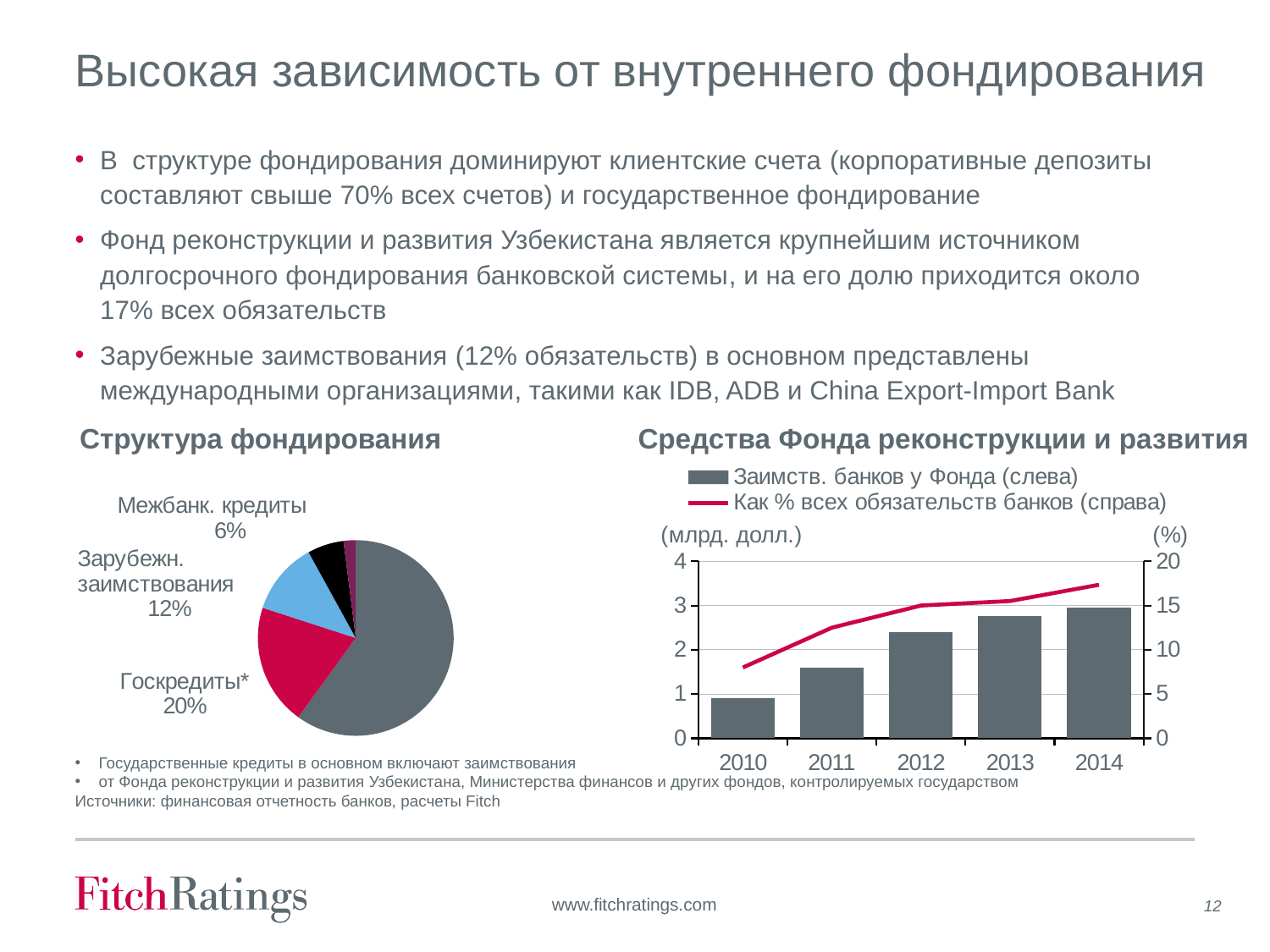
In the pie chart 'Структура фондирования', what share is shown for Госкредиты*? 20% What type of chart is 'Структура фондирования'? Pie chart How many series does the legend of the chart 'Средства Фонда реконструкции и развития' list? 2 In the pie chart 'Структура фондирования', what share is shown for Зарубежн. заимствования? 12% In the pie chart 'Структура фондирования', by how many percentage points does Госкредиты* exceed Зарубежн. заимствования? 8 percentage points In the chart 'Средства Фонда реконструкции и развития', what unit is shown on the left axis? млрд. долл. How many years are shown on the x axis of the chart 'Средства Фонда реконструкции и развития'? 5 In the pie chart 'Структура фондирования', which is larger: Межбанк. кредиты or Зарубежн. заимствования? Зарубежн. заимствования In the chart 'Средства Фонда реконструкции и развития', do the bars for 'Заимств. банков у Фонда' rise or fall from 2010 to 2014? Rise In the chart 'Средства Фонда реконструкции и развития', which year has the lowest bar for 'Заимств. банков у Фонда'? 2010 In the pie chart 'Структура фондирования', what share is shown for Межбанк. кредиты? 6%